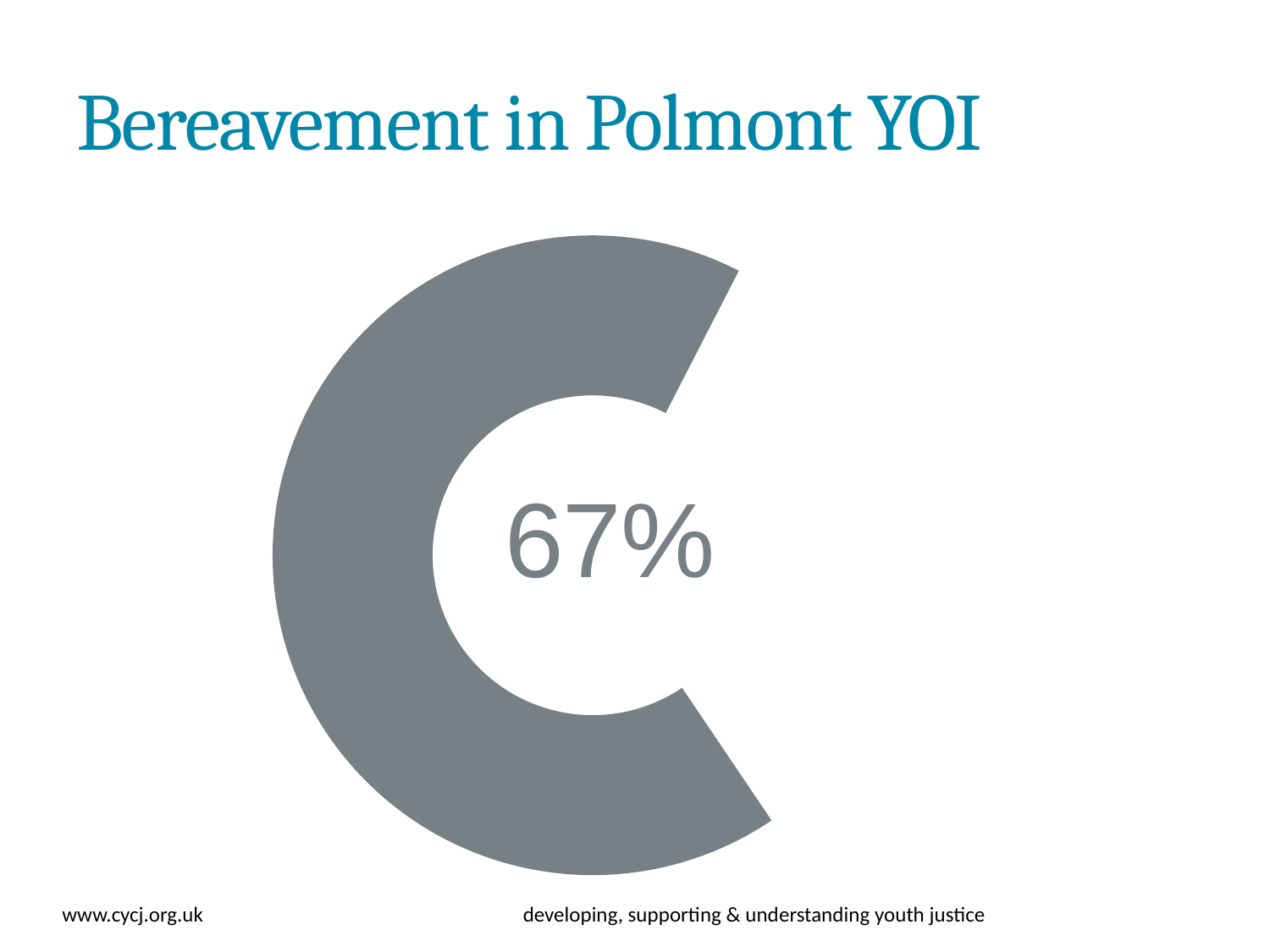
Is the value shown on the doughnut chart greater or less than 75%? less What kind of chart is shown on the slide? Doughnut chart What colour is the filled segment of the doughnut chart? Grey What share of the doughnut does the grey segment represent? 67% What percentage is printed in the centre of the doughnut chart? 67% Is the value shown on the doughnut chart greater or less than 50%? greater What is the title of the slide containing the doughnut chart? Bereavement in Polmont YOI